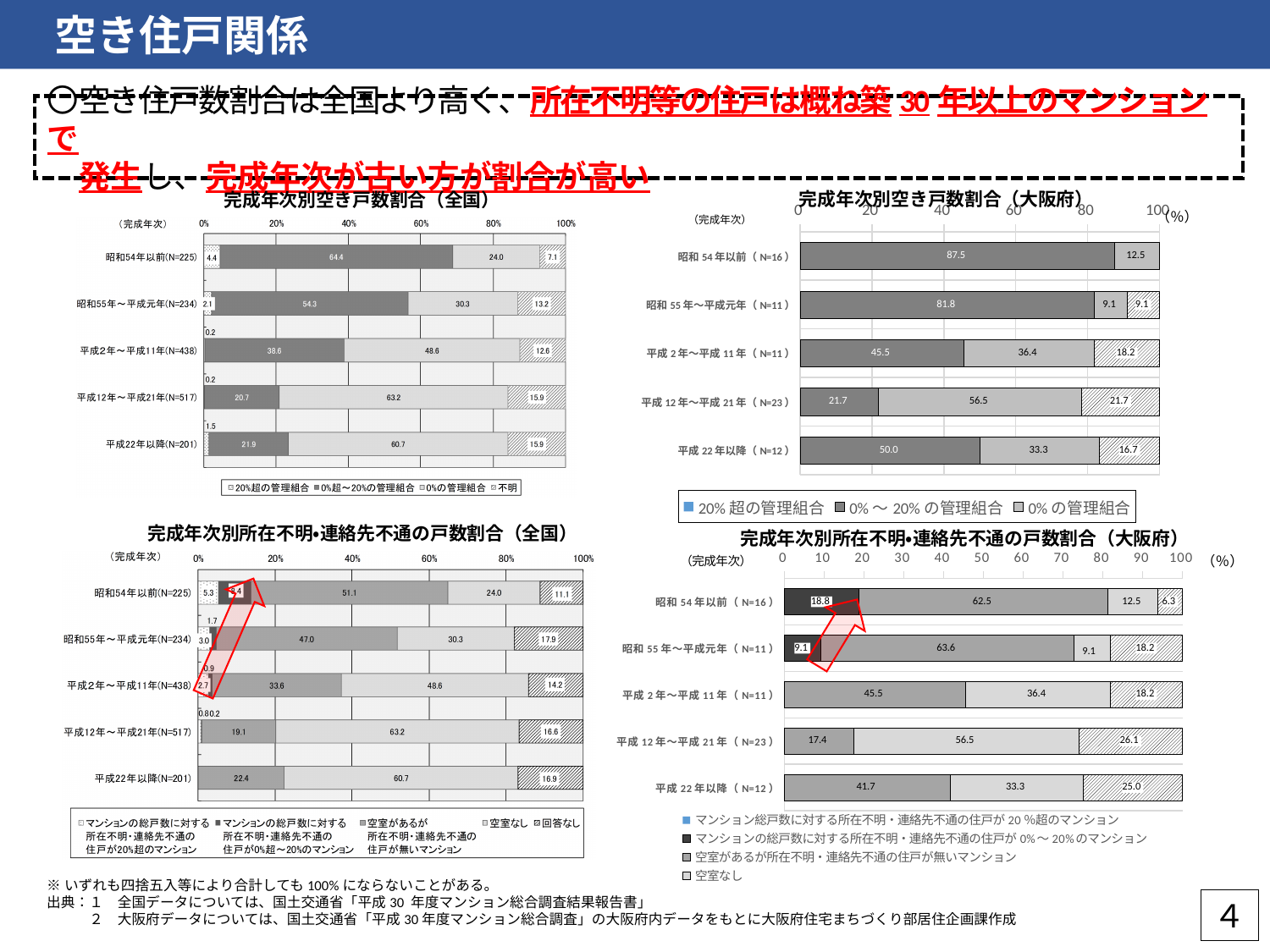
In the chart titled 完成年次別空き戸数割合（大阪府）, what is the value of the middle segment for 平成12年～平成21年 (N=23)? 56.5 In the chart titled 完成年次別所在不明・連絡先不通の戸数割合（全国）, what is the value of the 空室なし segment for 平成22年以降 (N=201)? 60.7 In the chart titled 完成年次別空き戸数割合（大阪府）, how many series does the legend list? 3 In the chart titled 完成年次別空き戸数割合（大阪府）, what is the value of the leftmost segment for 昭和54年以前 (N=16)? 87.5 In the chart titled 完成年次別所在不明・連絡先不通の戸数割合（大阪府）, which completion-year category has the largest leftmost (dark) segment? 昭和54年以前 (N=16) In the chart titled 完成年次別所在不明・連絡先不通の戸数割合（大阪府）, what is the value of the rightmost hatched segment for 平成12年～平成21年 (N=23)? 26.1 In the chart titled 完成年次別空き戸数割合（大阪府）, how many completion-year categories are shown? 5 In the chart titled 完成年次別所在不明・連絡先不通の戸数割合（大阪府）, what is the value of the leftmost (dark) segment for 昭和54年以前 (N=16)? 18.8 In the chart titled 完成年次別空き戸数割合（全国）, what is the value of the 不明 (hatched) segment for 昭和55年～平成元年 (N=234)? 13.2 In the chart titled 完成年次別所在不明・連絡先不通の戸数割合（大阪府）, what is the difference between the leftmost segment values for 昭和54年以前 (18.8) and 昭和55年～平成元年 (9.1)? 9.7 What type of chart is 完成年次別空き戸数割合（大阪府）? Stacked bar chart In the chart titled 完成年次別空き戸数割合（全国）, what is the value of the 0%の管理組合 segment for 平成12年～平成21年 (N=517)? 63.2